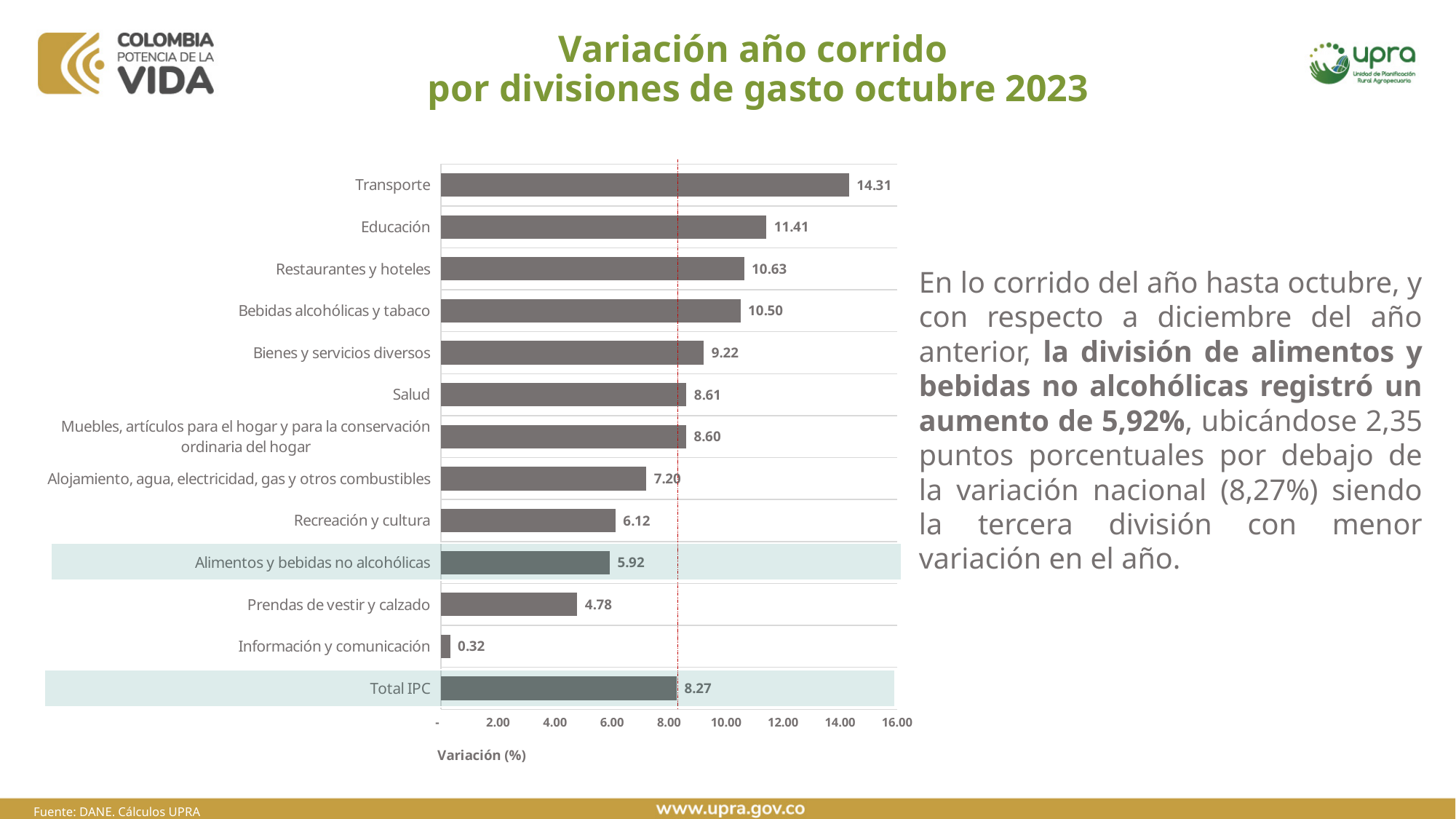
What is the difference between the Total IPC value and the value for Alimentos y bebidas no alcohólicas? 2.35 Which is larger, the value for Salud or the value for Recreación y cultura? Salud What is the value for Transporte? 14.31 Which division has the lowest variation? Información y comunicación Is the value for Prendas de vestir y calzado greater or less than 6.00? less What is the label of the horizontal axis? Variación (%) Which division has the highest variation? Transporte What is the value for Alimentos y bebidas no alcohólicas? 5.92 What is the value for Total IPC? 8.27 What kind of chart is shown on the slide? bar chart What is the difference between the values for Transporte and Educación? 2.90 How many bars are shown in the chart? 13